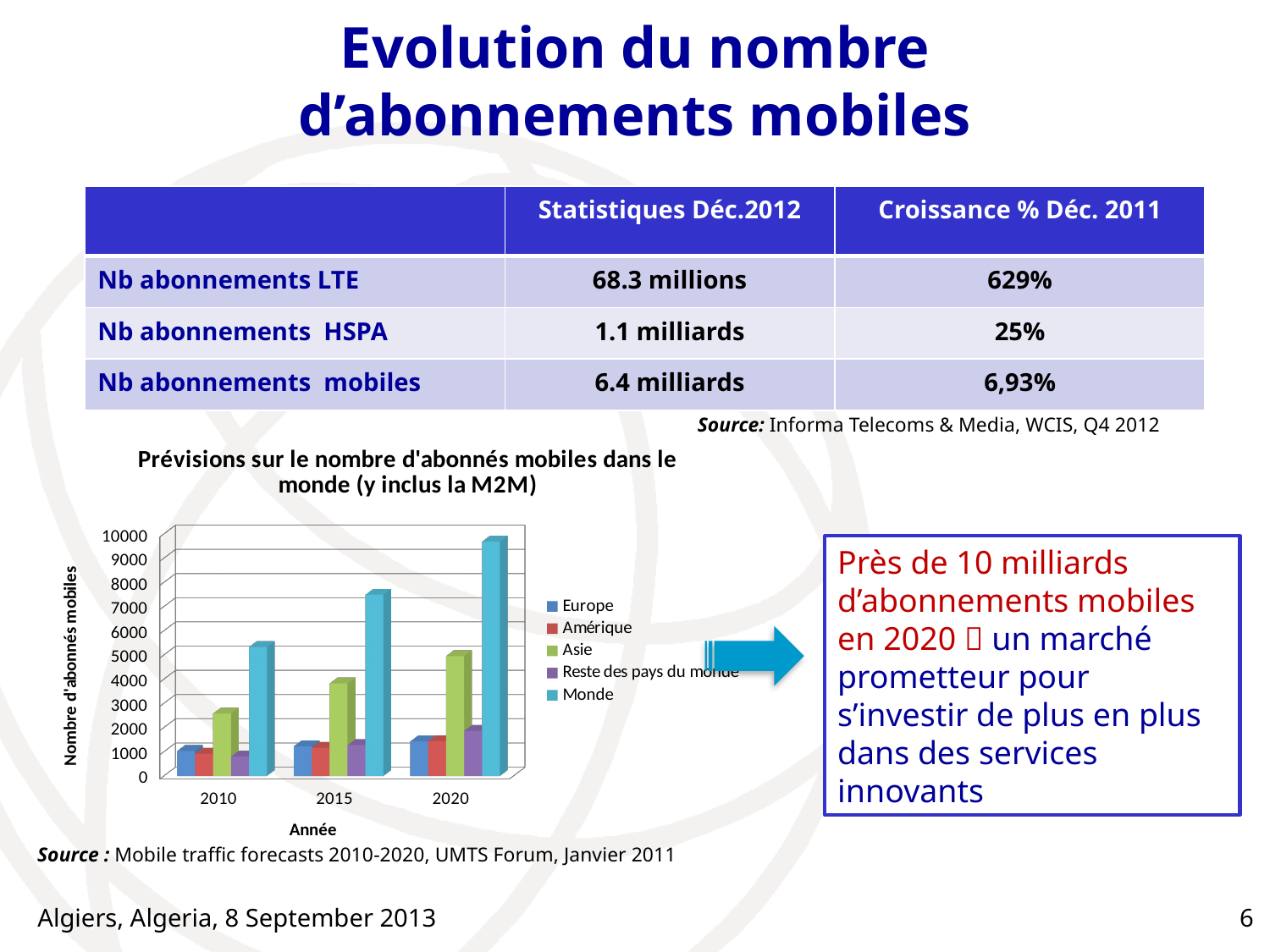
Which is larger in 2020, Asie or Europe? Asie In which year is the Monde series highest? 2020 What is the label of the x axis of the chart? Année Is the value for Monde in 2020 greater or less than 9000? greater How many years are shown on the x axis of the chart? 3 What kind of chart is shown on the slide? bar chart Is the value for Monde in 2015 greater or less than 7000? greater What is the label of the y axis of the chart? Nombre d'abonnés mobiles How many series does the chart legend list? 5 Is the value for Asie in 2010 greater or less than 2000? greater Do the values for Monde rise or fall from 2010 to 2020? rise